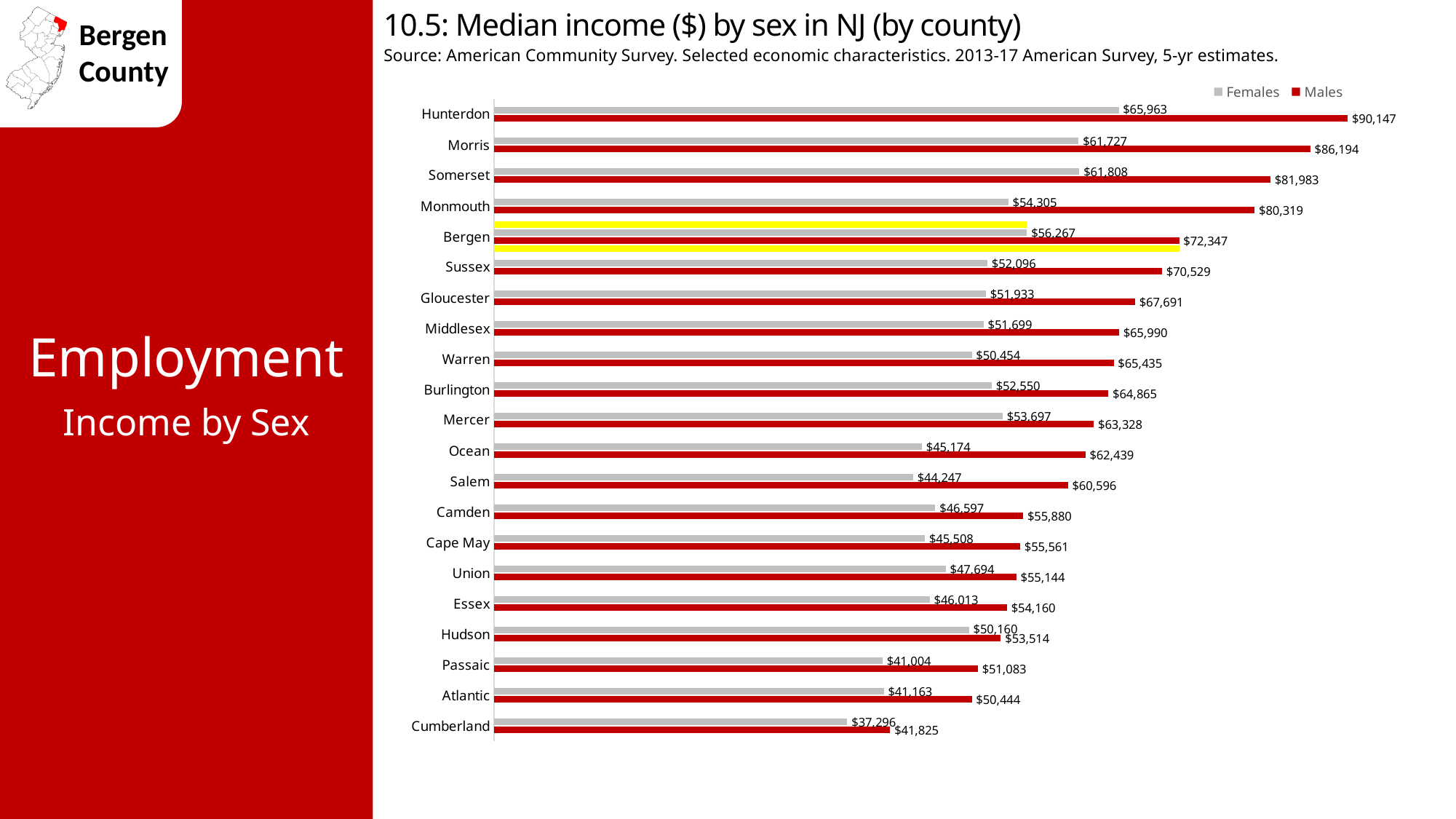
What is the median income for females in Bergen County? $56,267 What type of chart is shown on the slide? Bar chart What is the median income for males in Hunterdon County? $90,147 How many counties are shown in the chart? 21 What is the median income for females in Cumberland County? $37,296 How many series does the legend list? 2 Which county has the highest median income for females? Hunterdon What is the median income for males in Bergen County? $72,347 What is the difference between male and female median income in Bergen County? $16,080 Which is larger, the female median income in Bergen County or in Monmouth County? Bergen Which county has the lowest median income for males? Cumberland What is the difference between male and female median income in Hunterdon County? $24,184